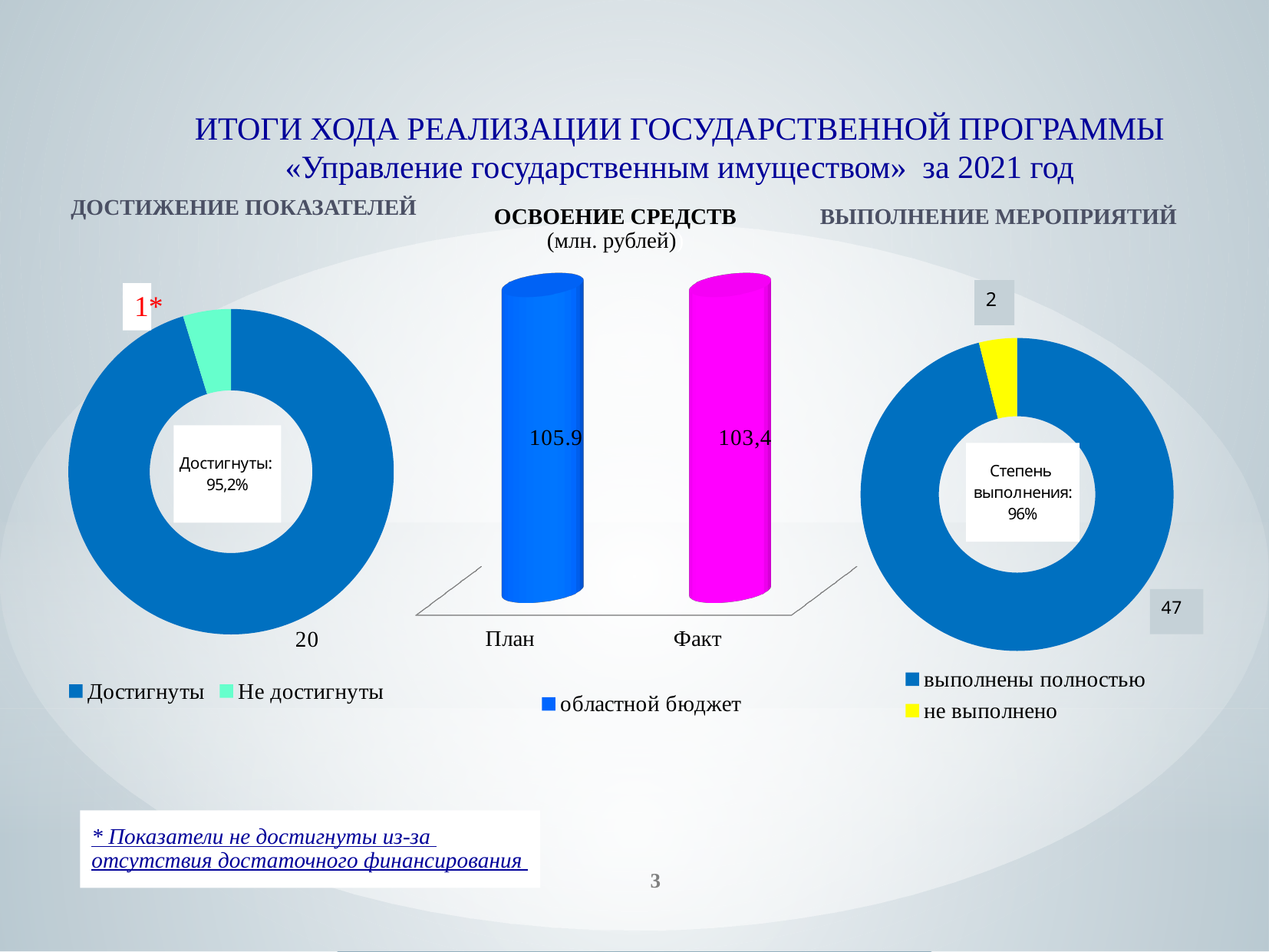
In the 'ОСВОЕНИЕ СРЕДСТВ' chart, what is the value for План? 105.9 In the 'ДОСТИЖЕНИЕ ПОКАЗАТЕЛЕЙ' chart, what is the value for Достигнуты? 20 In the 'ДОСТИЖЕНИЕ ПОКАЗАТЕЛЕЙ' chart, which category is the largest? Достигнуты In the 'ВЫПОЛНЕНИЕ МЕРОПРИЯТИЙ' chart, what is the difference between 'выполнены полностью' and 'не выполнено'? 45 In the 'ВЫПОЛНЕНИЕ МЕРОПРИЯТИЙ' chart, what is the value for 'выполнены полностью'? 47 In the 'ДОСТИЖЕНИЕ ПОКАЗАТЕЛЕЙ' chart, what percentage is shown in the centre for Достигнуты? 95,2% In the 'ВЫПОЛНЕНИЕ МЕРОПРИЯТИЙ' chart, what is the value for 'не выполнено'? 2 In the 'ОСВОЕНИЕ СРЕДСТВ' chart, what is the value for Факт? 103,4 In the 'ОСВОЕНИЕ СРЕДСТВ' chart, which is larger, План or Факт? План In the 'ОСВОЕНИЕ СРЕДСТВ' chart, what kind of chart is shown? Bar chart In the 'ОСВОЕНИЕ СРЕДСТВ' chart, how many bars are plotted? 2 In the 'ОСВОЕНИЕ СРЕДСТВ' chart, what series does the legend list? областной бюджет